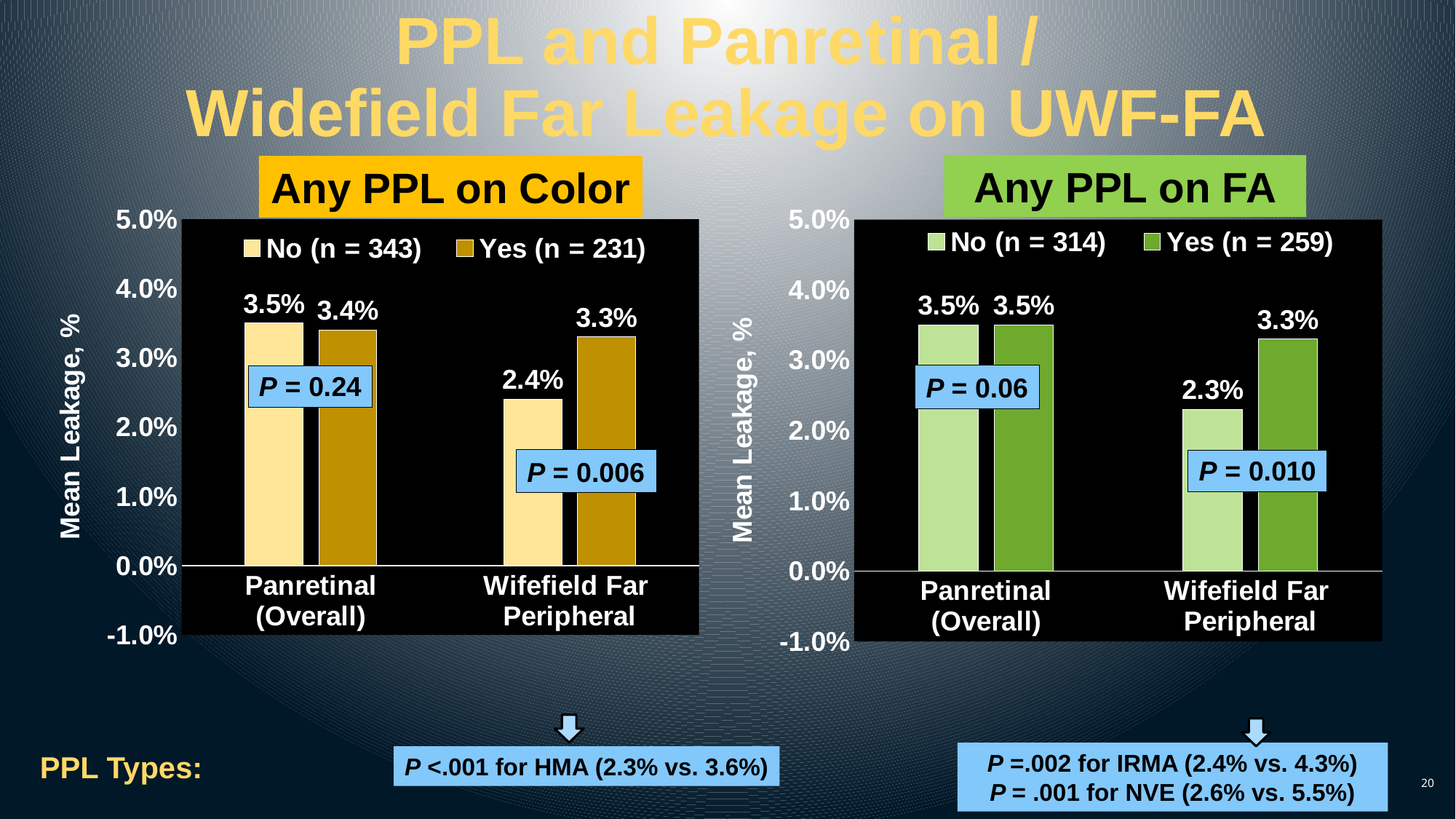
In the 'Any PPL on Color' chart, what sample size is given for the 'Yes' group in the legend? n = 231 How many series does the legend of the 'Any PPL on FA' chart list? 2 In the 'Any PPL on Color' chart, what is the mean leakage for the 'No' group in the Panretinal (Overall) category? 3.5% What kind of chart is the 'Any PPL on FA' chart? Bar chart In the 'Any PPL on Color' chart, what is the difference between the 'Yes' and 'No' values in the Wifefield Far Peripheral category? 0.9% In the 'Any PPL on Color' chart, which is larger in the Wifefield Far Peripheral category: the 'No' bar or the 'Yes' bar? Yes In the 'Any PPL on Color' chart, which bar has the lowest value? No, Wifefield Far Peripheral (2.4%) How many categories are shown on the x axis of the 'Any PPL on Color' chart? 2 In the 'Any PPL on FA' chart, what is the difference between the 'Yes' and 'No' values in the Wifefield Far Peripheral category? 1.0% In the 'Any PPL on FA' chart, what is the mean leakage for the 'No' group in the Wifefield Far Peripheral category? 2.3% In the 'Any PPL on FA' chart, what is the mean leakage for the 'Yes' group in the Panretinal (Overall) category? 3.5% In the 'Any PPL on Color' chart, what is the mean leakage for the 'Yes' group in the Wifefield Far Peripheral category? 3.3%